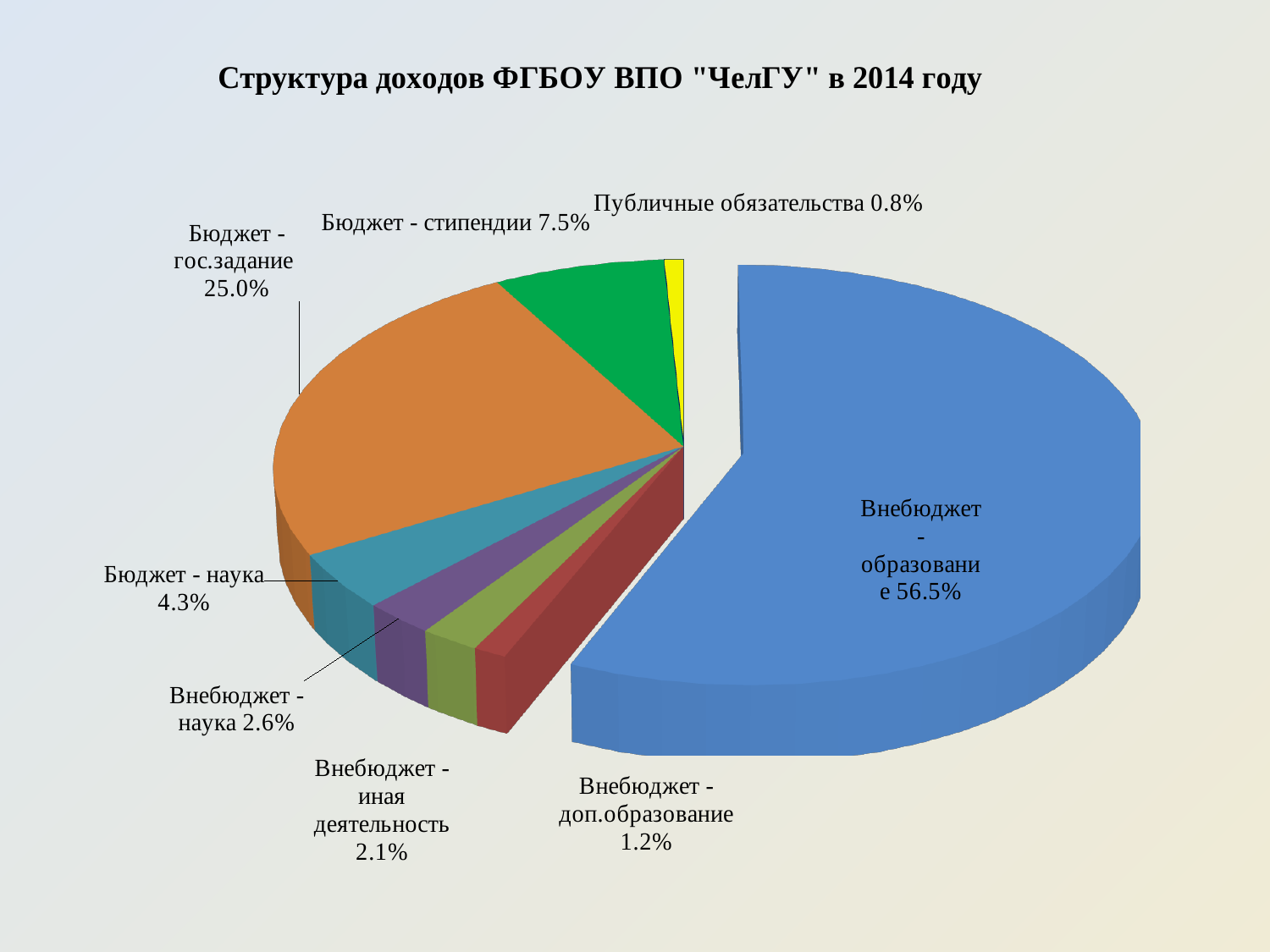
Which category has the largest slice of the pie? Внебюджет - образование What is the value shown for "Бюджет - гос.задание"? 25.0% What colour is the slice for "Внебюджет - образование"? Blue What percentage is labelled for "Бюджет - стипендии"? 7.5% What is the value for "Публичные обязательства"? 0.8% What is the difference between the shares of "Бюджет - гос.задание" and "Бюджет - стипендии"? 17.5% What share of income does "Внебюджет - образование" account for? 56.5% What is the title of the chart? Структура доходов ФГБОУ ВПО "ЧелГУ" в 2014 году What type of chart is shown on the slide? Pie chart How many slices does the pie chart have? 8 Which category has the smallest slice of the pie? Публичные обязательства Which is larger: "Бюджет - наука" or "Внебюджет - наука"? Бюджет - наука